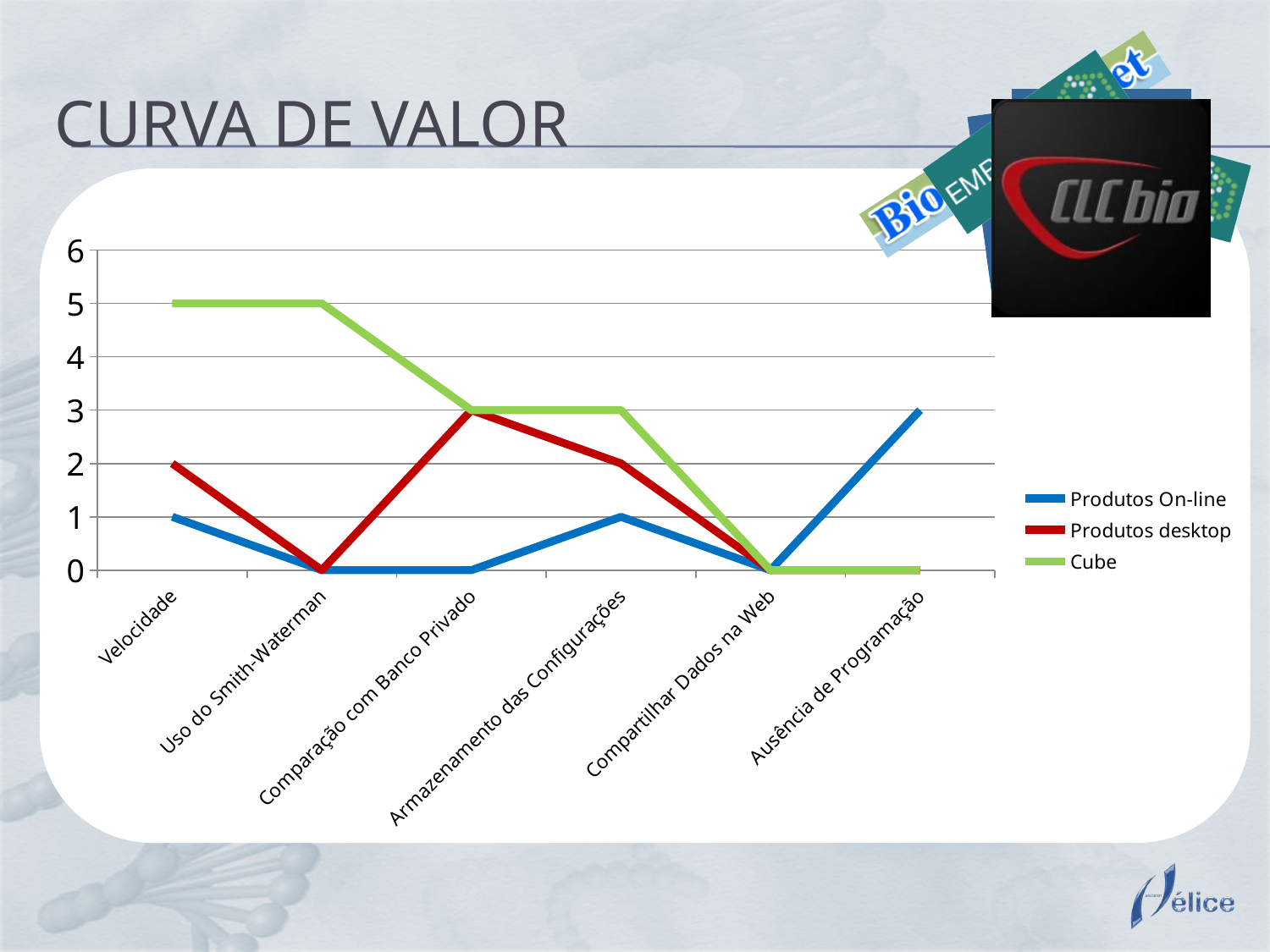
What kind of chart is shown on the slide? line chart What is the difference between Cube and Produtos On-line for Uso do Smith-Waterman? 5 How many categories are shown on the x axis? 6 Which is larger for Armazenamento das Configurações, Produtos desktop or Produtos On-line? Produtos desktop What is the value of Cube for Velocidade? 5 What is the value of Produtos desktop for Comparação com Banco Privado? 3 Does the Cube series rise or fall from Velocidade to Compartilhar Dados na Web? fall What is the value of Cube for Compartilhar Dados na Web? 0 What is the title of the slide containing the chart? CURVA DE VALOR Which series has the highest value for Velocidade? Cube What is the value of Produtos On-line for Ausência de Programação? 3 How many series does the legend list? 3